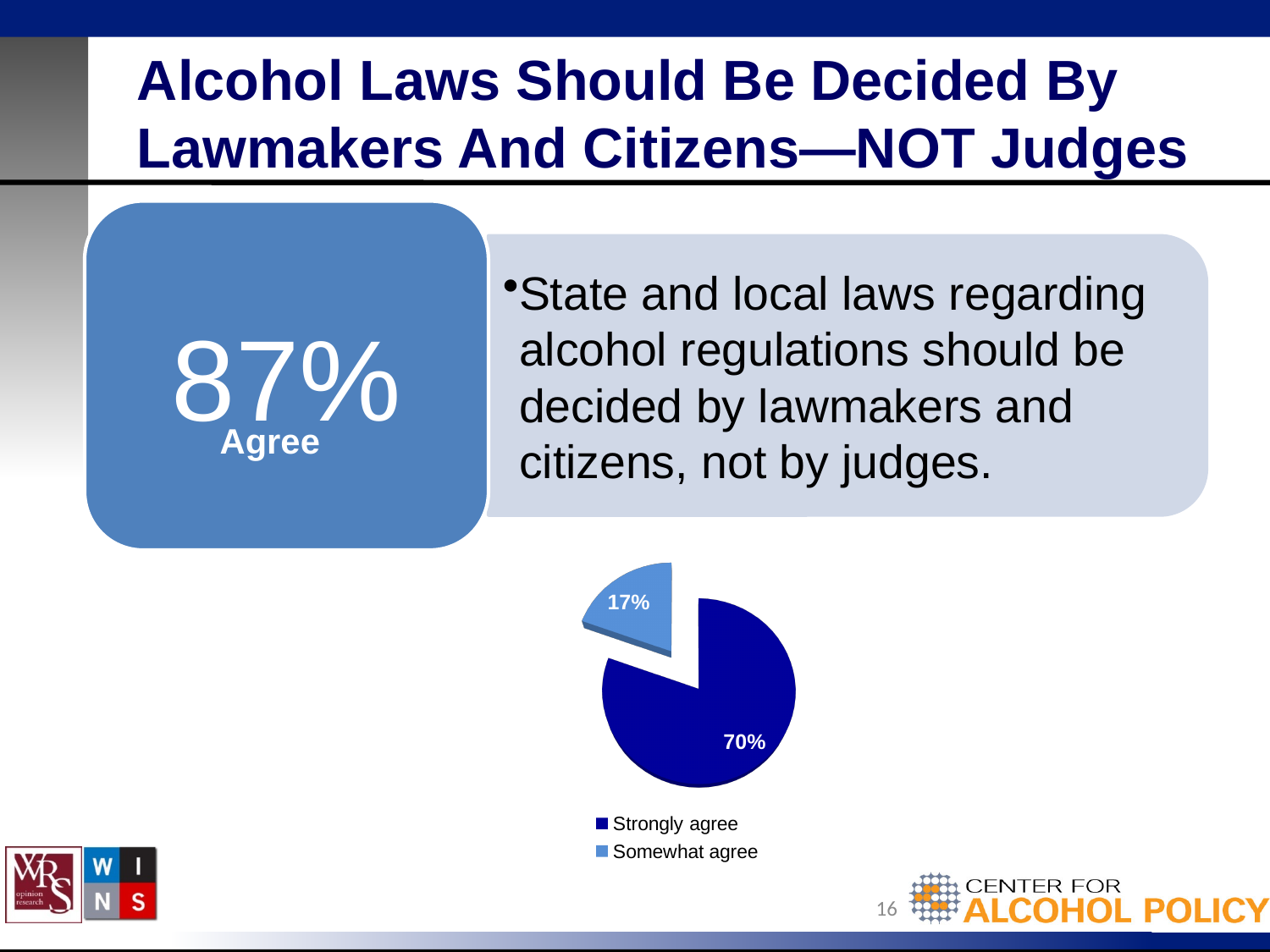
What is the combined percentage of Strongly agree and Somewhat agree? 87% How many slices does the pie chart have? 2 What kind of chart is shown on the slide? pie chart What overall percentage is shown in the large box labelled Agree? 87% What colour is the Strongly agree slice? dark blue What percentage of respondents somewhat agree? 17% How many entries does the legend list? 2 What is the difference between the Strongly agree and Somewhat agree percentages? 53% Which is larger, the Strongly agree slice or the Somewhat agree slice? Strongly agree What percentage of respondents strongly agree? 70% Which slice of the pie chart is the largest? Strongly agree Which slice of the pie chart is the smallest? Somewhat agree